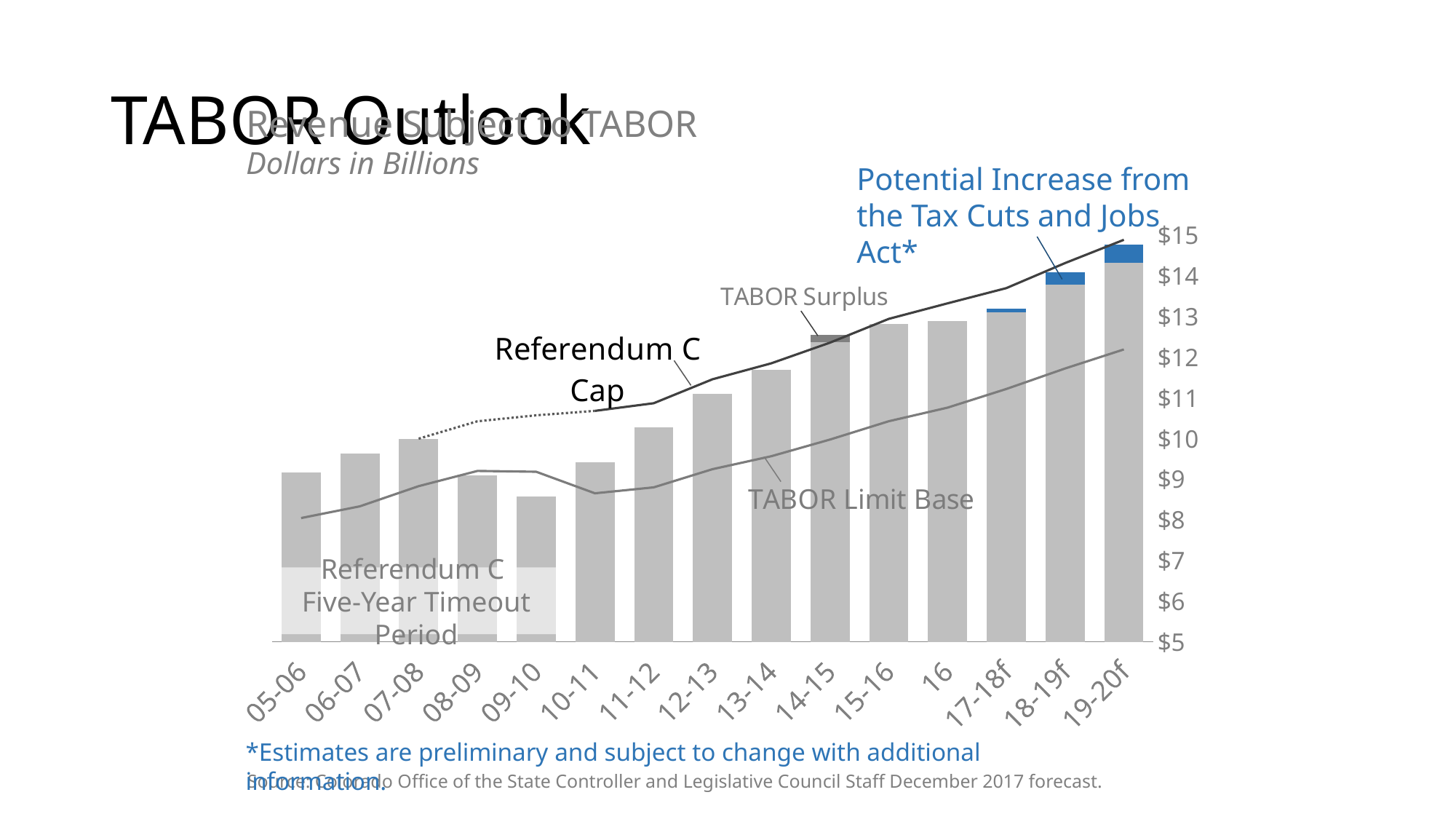
Which fiscal year has the shortest bar? 09-10 What unit does the chart subtitle say the values are in? Dollars in Billions What is the title of the chart? Revenue Subject to TABOR Which bar is taller, 07-08 or 08-09? 07-08 What kind of chart is shown on the slide? combination bar and line chart How many fiscal-year bars are plotted on the chart? 15 Do the bars generally rise or fall from 10-11 through 19-20f? rise Is the bar for 14-15 greater or less than $12? greater Is the bar for 09-10 greater or less than $9? less Is the bar for 13-14 greater or less than $12? less Which fiscal year has the tallest bar? 19-20f